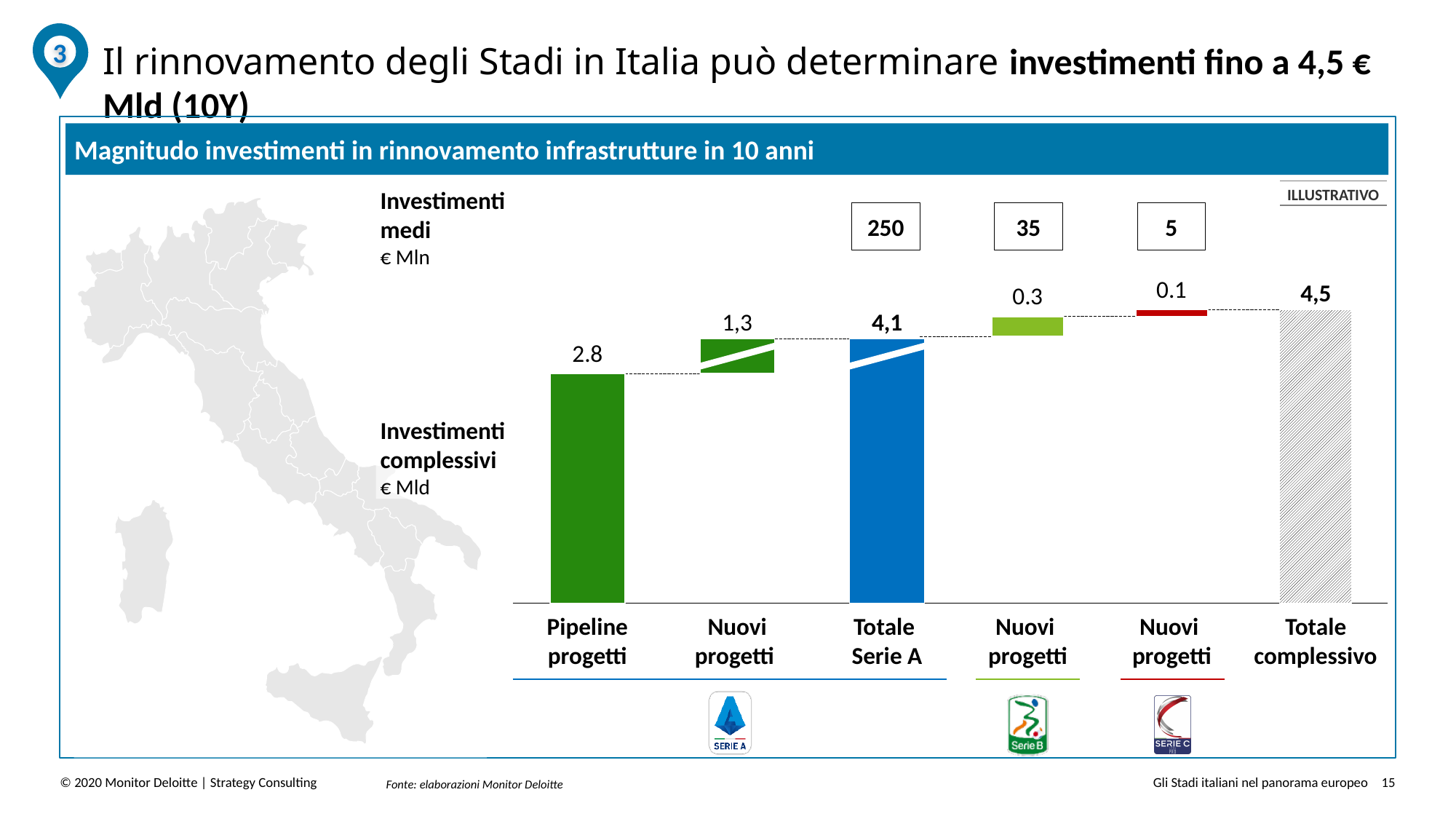
What is the value of the 'Nuovi progetti' bar for Serie C (the red bar, fifth from the left)? 0.1 What is the value shown for 'Totale Serie A' in the chart? 4,1 How many categories are shown along the x axis of the chart? 6 What is the title of the chart? Magnitudo investimenti in rinnovamento infrastrutture in 10 anni What is the difference between 'Totale complessivo' and 'Totale Serie A'? 0,4 What is the value of the 'Nuovi progetti' bar for Serie B (the green bar, fourth from the left)? 0.3 Which category has the lowest value in the chart? Nuovi progetti (Serie C) What is the 'Investimenti medi' (€ Mln) figure shown above the Serie C column? 5 What is the value of the 'Totale complessivo' bar in the chart? 4,5 Which category has the highest value in the chart? Totale complessivo What is the 'Investimenti medi' (€ Mln) figure shown above the Serie A column? 250 What is the value of the 'Pipeline progetti' bar in the chart? 2.8